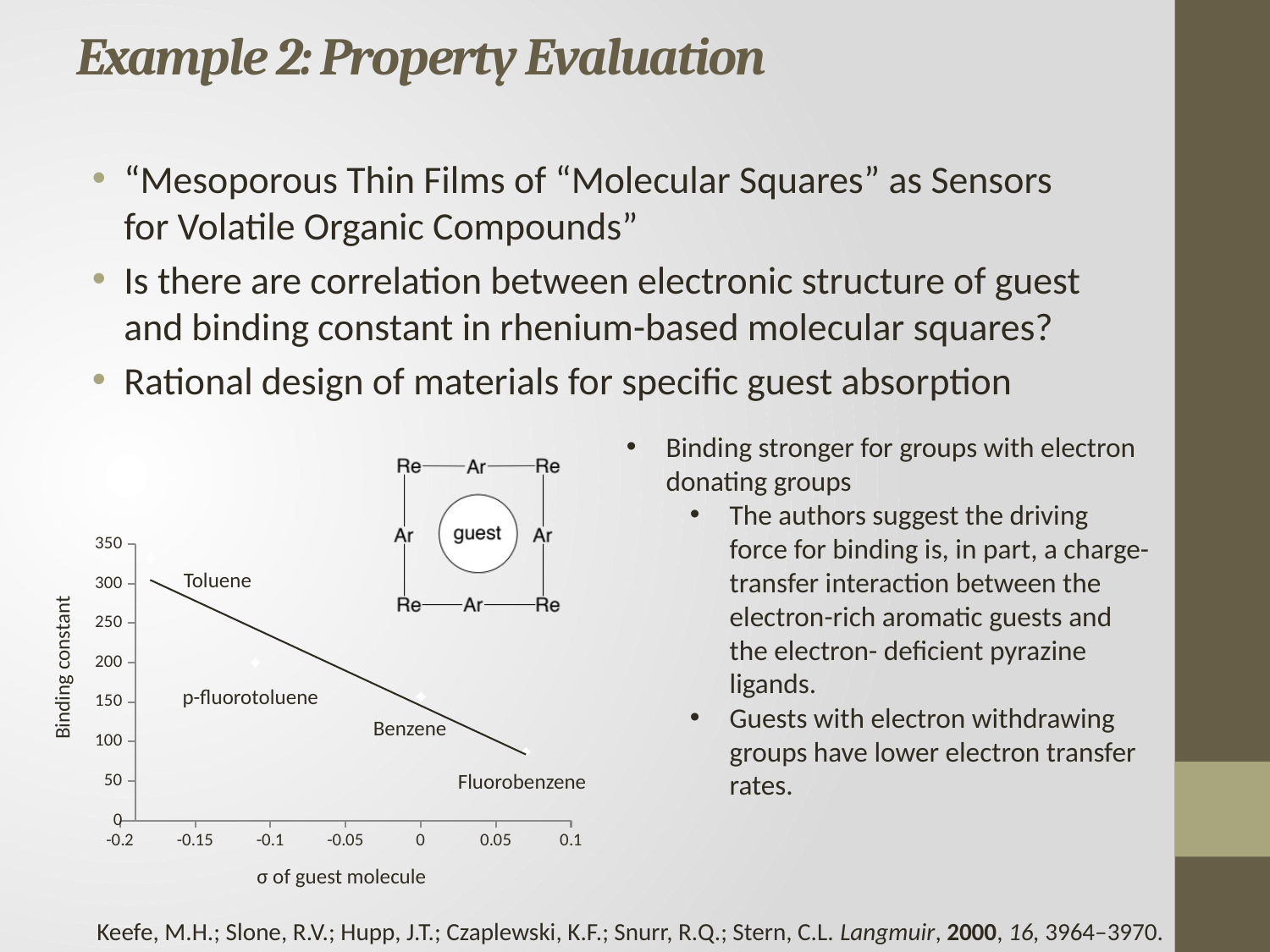
What is the title of the x axis of the chart? σ of guest molecule Is the binding constant for Fluorobenzene greater or less than 100? less Is the binding constant for Toluene greater or less than 300? greater Which guest molecule has the lowest binding constant on the chart? Fluorobenzene Which guest molecule has the highest binding constant on the chart? Toluene Is the binding constant for Benzene greater or less than 200? less Which has a larger binding constant, Toluene or Benzene? Toluene What is the σ value of Benzene on the x axis? 0 What kind of chart is shown on the slide? Scatter chart Which has a larger binding constant, p-fluorotoluene or Fluorobenzene? p-fluorotoluene How many labelled data points are plotted on the chart? 4 Does the binding constant rise or fall as σ of the guest molecule increases? Fall